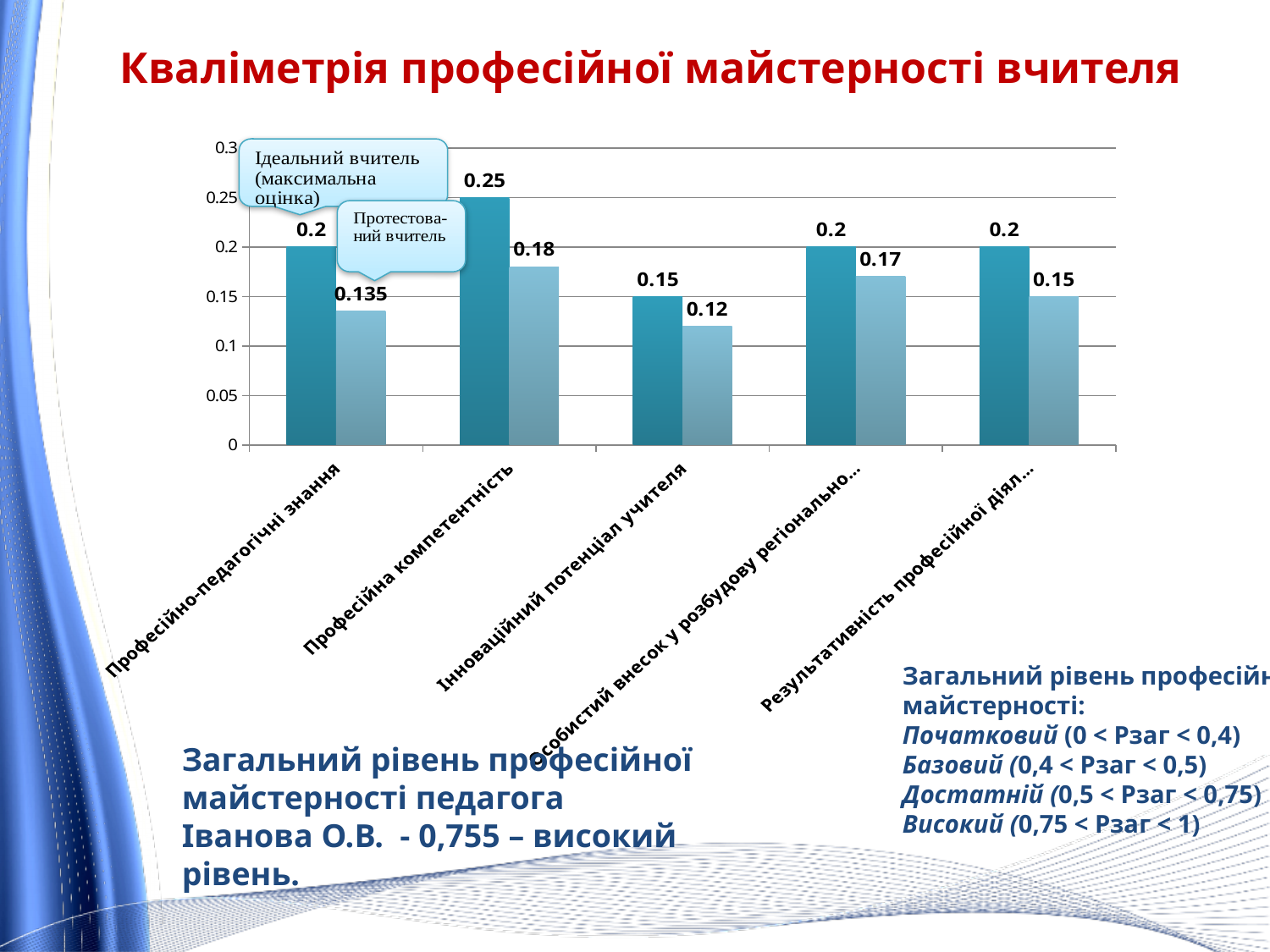
What is the difference between the darker bar and the lighter bar for 'Професійно-педагогічні знання'? 0.065 What is the title of the slide containing the chart? Кваліметрія професійної майстерності вчителя What is the value of the darker bar (Ідеальний вчитель, максимальна оцінка) for the category 'Інноваційний потенціал учителя'? 0.15 How many categories are shown on the x axis of the chart? 5 Is the lighter bar (Протестований вчитель) for 'Професійна компетентність' greater or less than 0.15? greater Which category has the lowest value for the lighter bars (Протестований вчитель)? Інноваційний потенціал учителя Which category has the highest value for the darker bars (Ідеальний вчитель)? Професійна компетентність For the lighter bars (Протестований вчитель), which is larger: the value for 'Особистий внесок у розбудову регіонально...' or the value for 'Результативність професійної діял...'? Особистий внесок у розбудову регіонально... What type of chart is shown on the slide? bar chart What is the value of the lighter bar (Протестований вчитель) for the category 'Професійна компетентність'? 0.18 What is the difference between the darker bar and the lighter bar for 'Професійна компетентність'? 0.07 What is the value of the lighter bar (Протестований вчитель) for the category 'Професійно-педагогічні знання'? 0.135